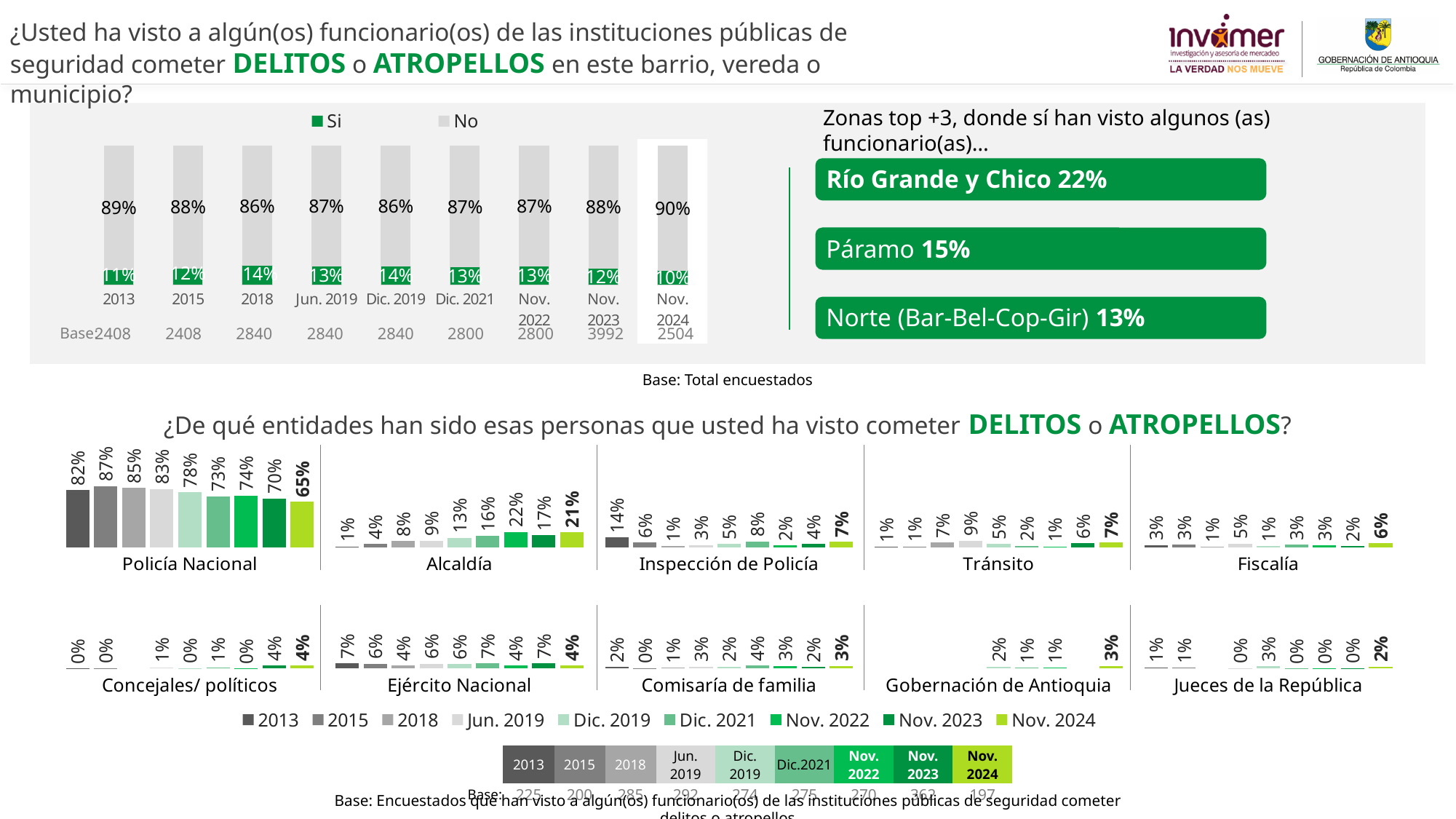
In the top chart (Si/No by year), how many time periods are shown on the x axis? 9 In the bottom chart (entities), which is larger for Nov. 2024: Alcaldía or Inspección de Policía? Alcaldía In the bottom chart (entities), how many series does the legend list? 9 In the bottom chart (entities), what is the difference between the 2013 and Nov. 2024 values for Policía Nacional? 17% In the top chart (Si/No by year), what percentage answered 'Si' in Nov. 2024? 10% In the bottom chart (entities), what is the Nov. 2024 value for Policía Nacional? 65% In the bottom chart (entities), what is the Nov. 2022 value for Alcaldía? 22% What type of chart is the bottom chart (entities)? Bar chart In the top chart (Si/No by year), how many series does the legend list? 2 In the top chart (Si/No by year), which year has the highest 'Si' percentage? 2018 and Dic. 2019 (14%) In the top chart (Si/No by year), what percentage answered 'No' in 2013? 89% In the bottom chart (entities), how does the Policía Nacional value change from Dic. 2019 to Nov. 2024? It falls